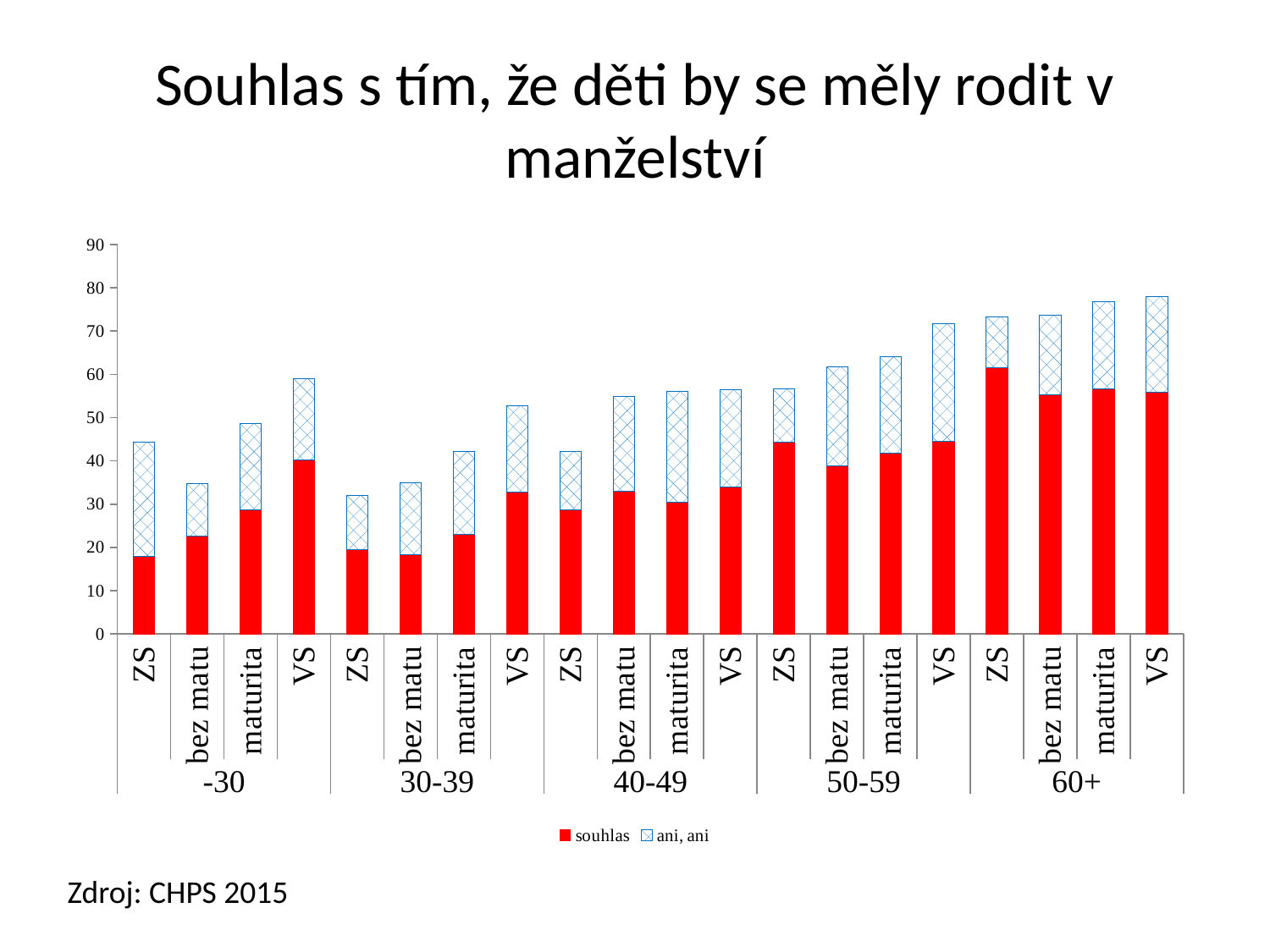
Is the 'souhlas' value for ZS in the 60+ group greater or less than 60? greater What kind of chart is shown on the slide? stacked bar chart Is the total height of the VS bar in the 50-59 group greater or less than 70? greater Is the 'souhlas' value for ZS in the -30 group greater or less than 20? less Does the 'souhlas' value for ZS rise or fall as the age groups go from -30 to 60+? rise What are the two series named in the legend? souhlas; ani, ani Which bar has the largest 'souhlas' (red) segment? ZS in the 60+ group Within the -30 group, which has the larger 'souhlas' segment: ZS or VS? VS How many age groups are shown along the x axis? 5 How many series does the legend list? 2 How many bars are plotted in the chart? 20 Which VS bar is taller in total: the one in the 40-49 group or the one in the 50-59 group? 50-59